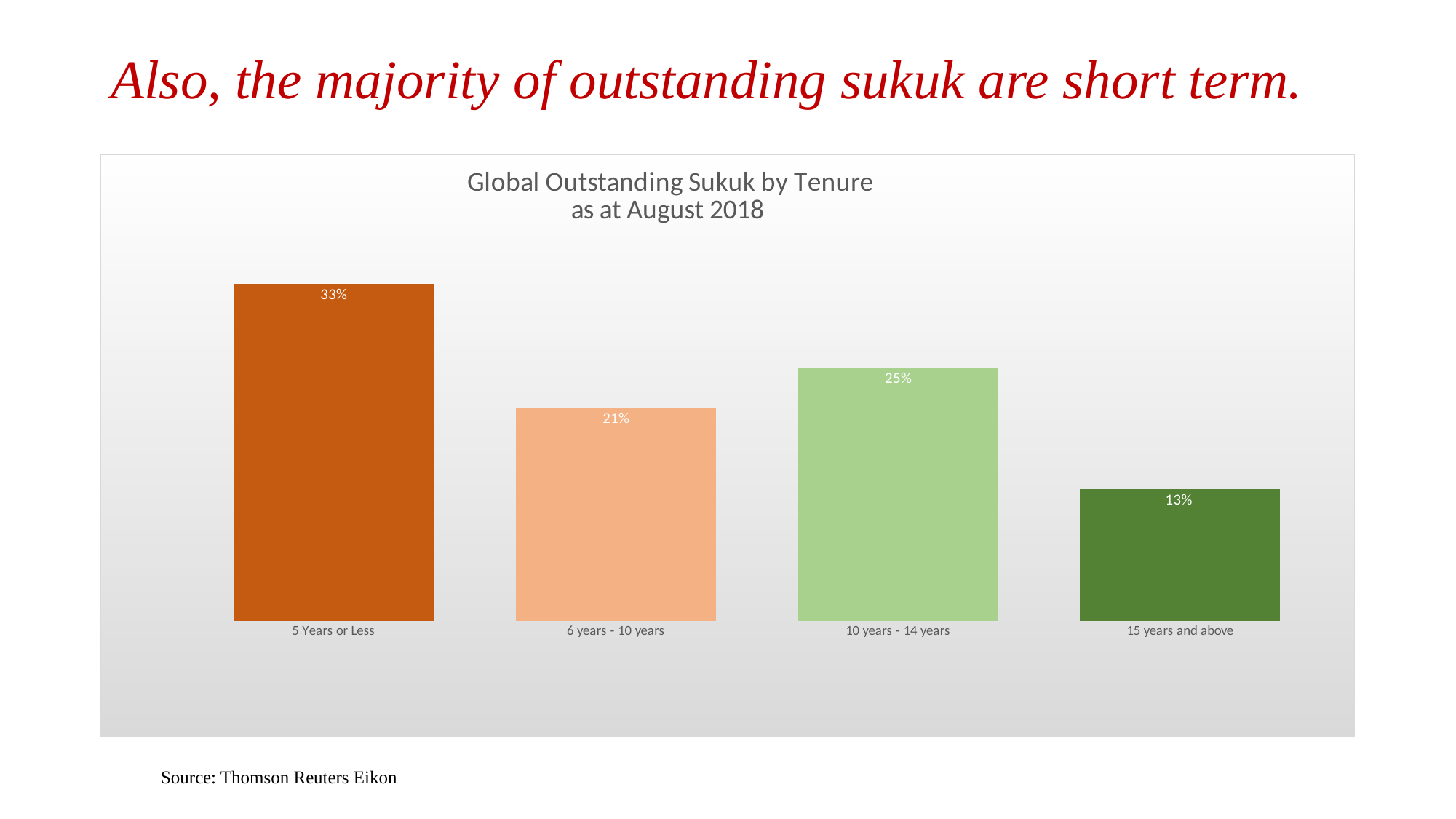
What is the value for 10 years - 14 years? 25% How many tenure categories are shown in the chart? 4 What is the difference between the values for 10 years - 14 years and 6 years - 10 years? 4% What is the value for 15 years and above? 13% Which is larger, the value for 6 years - 10 years or the value for 10 years - 14 years? 10 years - 14 years Which tenure category has the lowest value? 15 years and above What is the value for 6 years - 10 years? 21% Which tenure category has the highest value? 5 Years or Less What is the difference between the values for 5 Years or Less and 15 years and above? 20% What kind of chart is shown on the slide? Bar chart What is the title of the chart? Global Outstanding Sukuk by Tenure as at August 2018 What is the value for 5 Years or Less? 33%